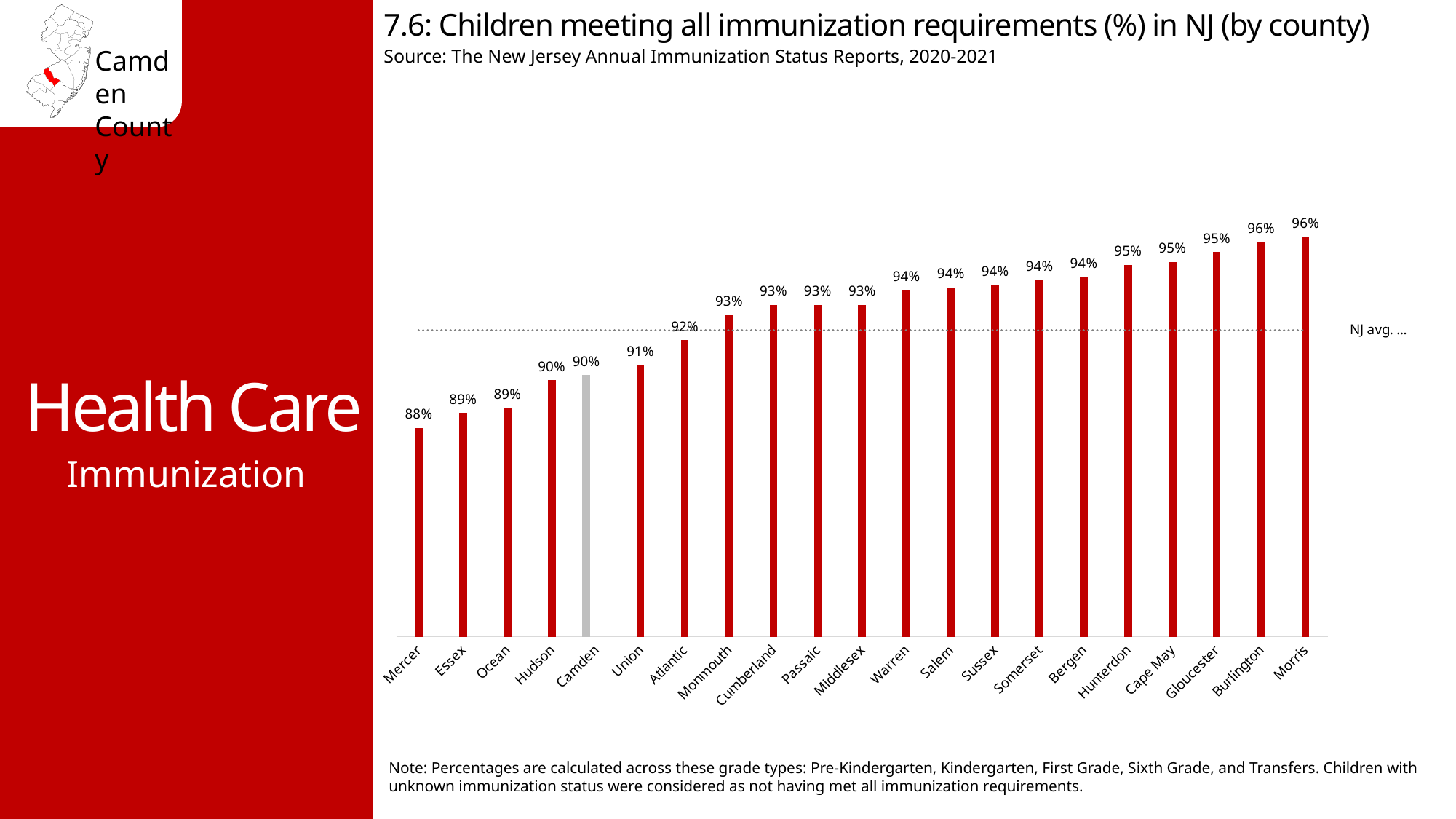
Do the values rise or fall from left to right across the counties? Rise What is the difference in percentage points between Morris County and Mercer County? 8 percentage points What percentage of children in Camden County met all immunization requirements? 90% How many counties are shown in the chart? 21 Which has a higher value, Camden or Bergen? Bergen What percentage is shown for Atlantic County? 92% What is the value shown for Mercer County? 88% Which county has the lowest percentage of children meeting all immunization requirements? Mercer What kind of chart is shown on the slide? Bar chart What is the value shown for Bergen County? 94% What is the difference in percentage points between Camden County and Mercer County? 2 percentage points Which county's bar is coloured grey instead of red? Camden